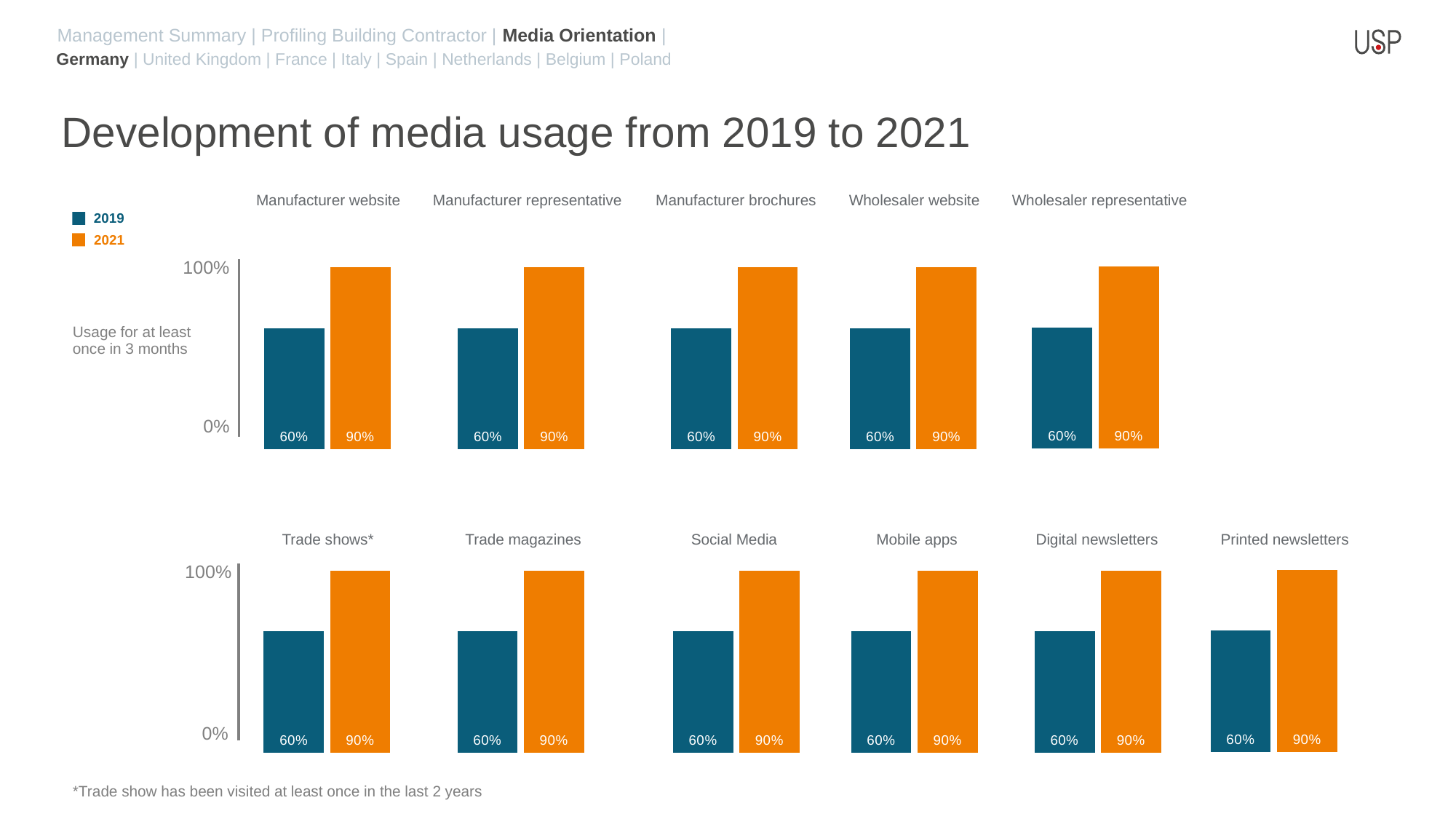
How many series does the legend list? 2 In the Social Media chart, what is the value for 2021? 90% In the Trade shows* chart, what is the value for 2021? 90% In the Mobile apps chart, which year has the lower value? 2019 In the Printed newsletters chart, what is the value for 2019? 60% In the Wholesaler representative chart, which year has the higher value? 2021 In the Manufacturer website chart, what is the value for 2019? 60% Which colour represents 2021 in the legend? orange What kind of chart is used on this slide? bar chart In the Digital newsletters chart, is the value for 2019 larger or smaller than the value for 2021? smaller In the Manufacturer brochures chart, what is the difference between the 2021 and 2019 values? 30% How many media categories are shown across the slide? 11